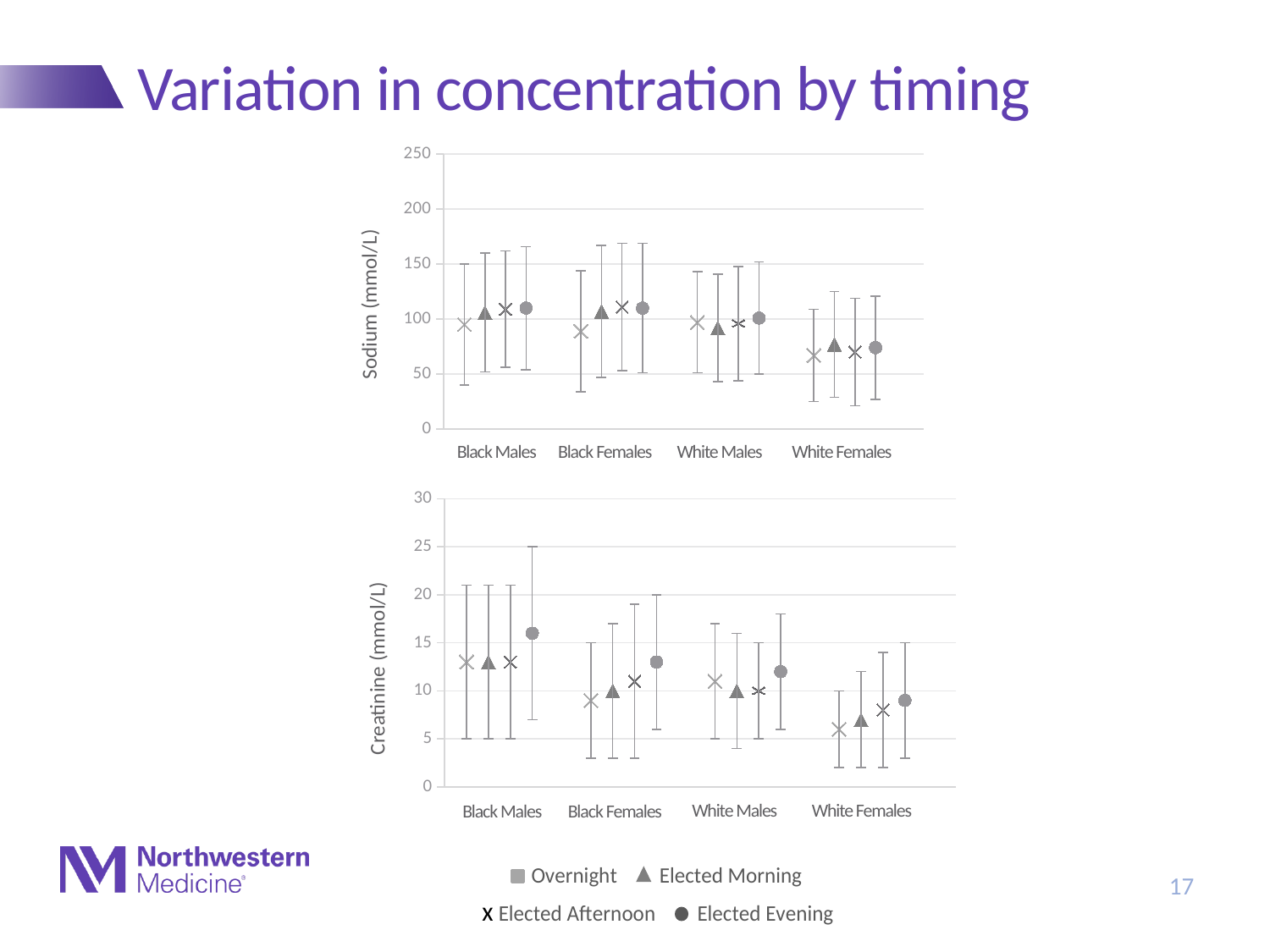
In the bottom chart (Creatinine), is the Overnight value for White Females greater or less than 10? less In the bottom chart (Creatinine), which category has the highest values? Black Males What is the y-axis label of the top chart? Sodium (mmol/L) In the top chart (Sodium), is the Elected Evening value for White Females greater or less than 100? less How many series does the legend list? 4 In the bottom chart (Creatinine), do the values generally rise or fall from Black Males to White Females? fall What kind of chart is the top chart (Sodium)? scatter chart In the top chart (Sodium), is the Elected Evening value for Black Females greater or less than 100? greater In the bottom chart (Creatinine), which is larger: the Elected Evening value for Black Males or for White Females? Black Males In the top chart (Sodium), which category has the lowest values? White Females How many categories are shown on the x axis of the bottom chart (Creatinine)? 4